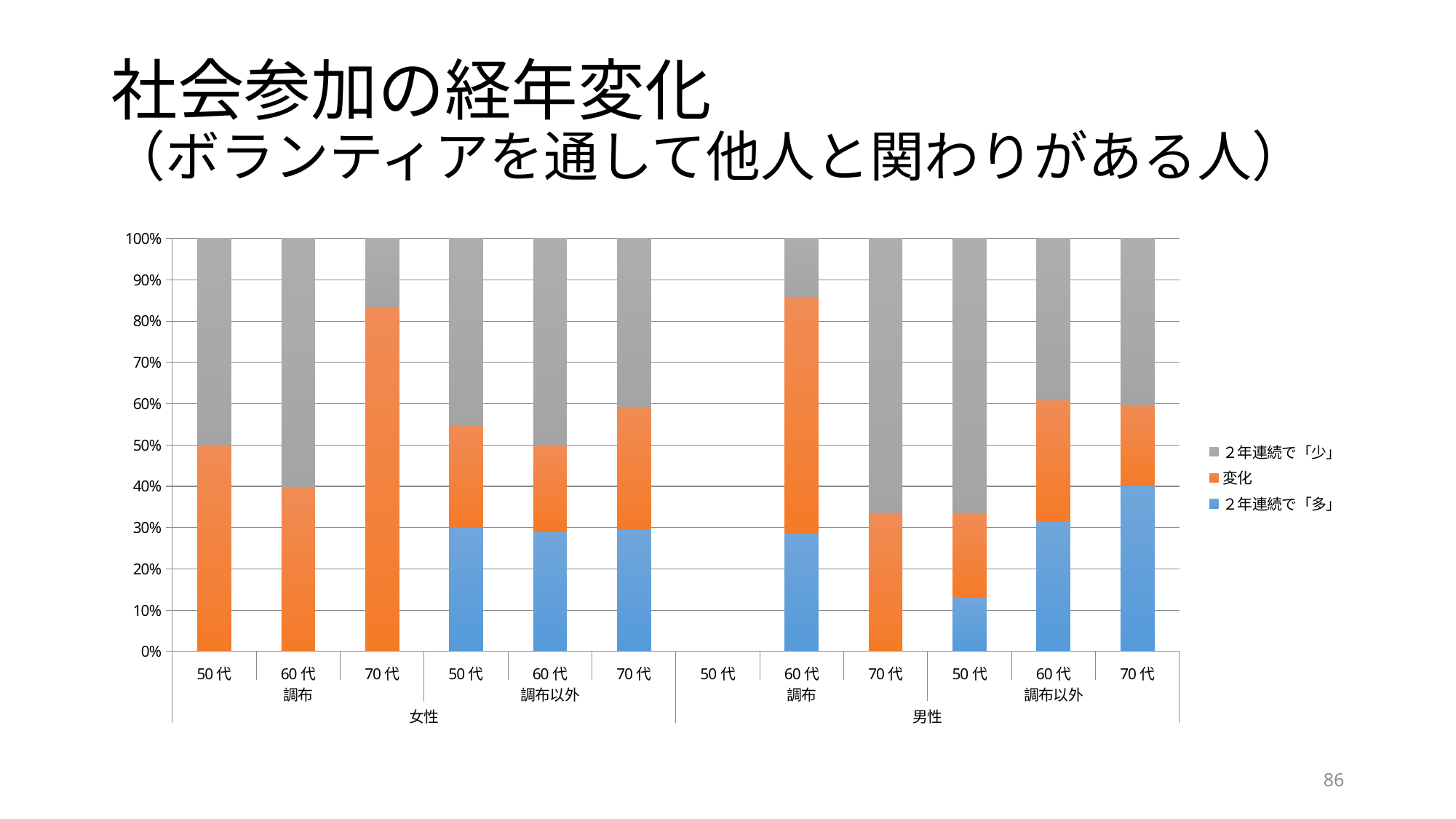
How many age-group categories are labelled along the x axis? 12 How many series does the legend list? 3 Which has the larger 2年連続で「少」 segment: 女性 調布 60代 or 女性 調布 70代? 女性 調布 60代 Which category on the x axis has no bar plotted? 男性 調布 50代 Is the top of the 変化 segment for 男性 調布 60代 greater or less than 80%? greater What kind of chart is shown on the slide? Stacked bar chart Is the 2年連続で「多」 value for 男性 調布以外 50代 greater or less than 20%? less Which category has the largest 2年連続で「多」 (blue) segment? 男性 調布以外 70代 Is the top of the 変化 segment for 女性 調布 70代 greater or less than 80%? greater Which series is shown in blue according to the legend? 2年連続で「多」 Which has the larger 2年連続で「多」 segment: 男性 調布以外 50代 or 男性 調布以外 70代? 男性 調布以外 70代 Which series is shown in grey according to the legend? 2年連続で「少」